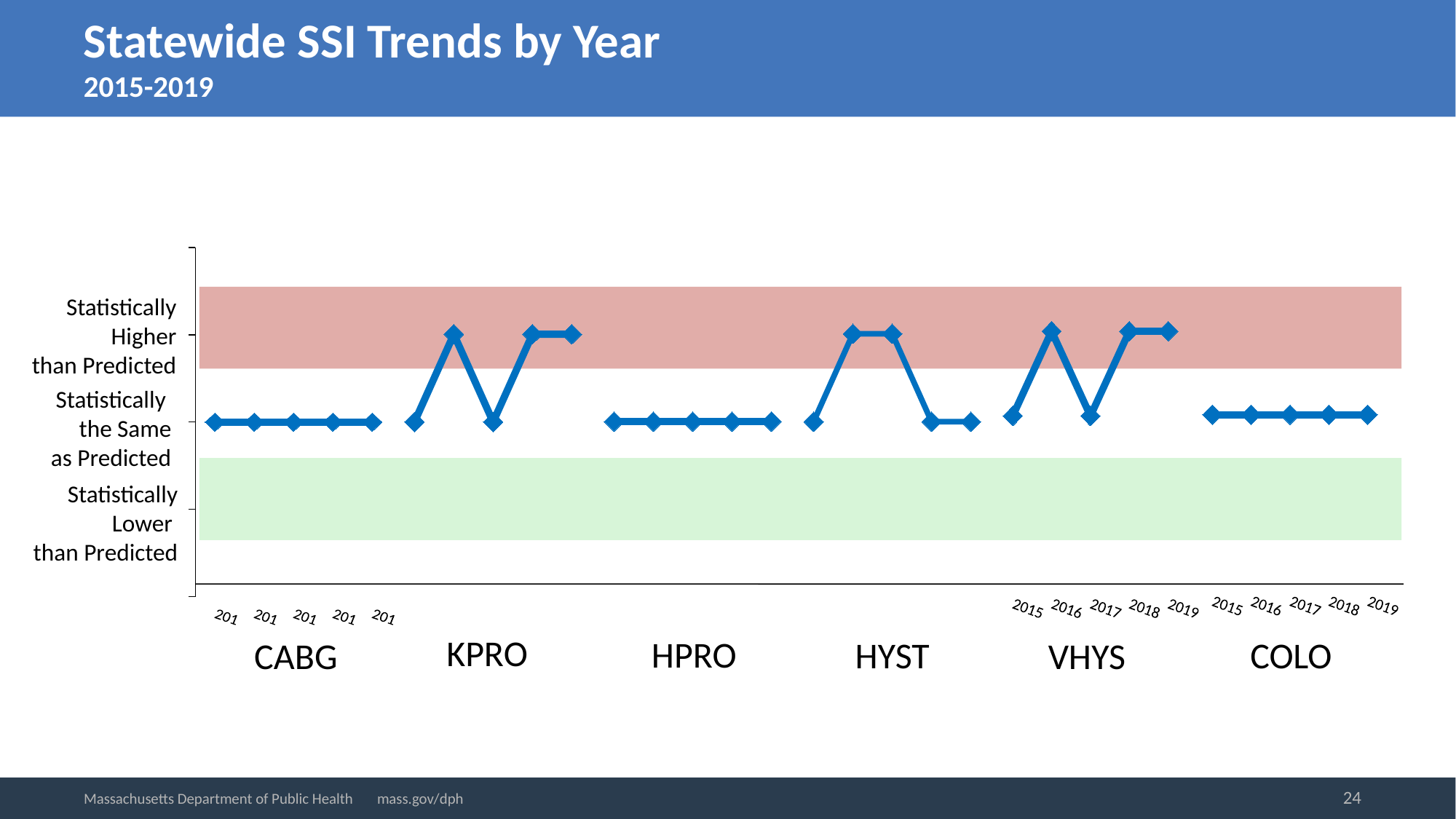
How many of the five VHYS points fall in the Statistically Higher than Predicted band? 3 In which band does the VHYS value for 2019 fall? Statistically Higher than Predicted How many data points are plotted for the VHYS group? 5 Do any points on the chart fall in the Statistically Lower than Predicted band? No In which band does the COLO value for 2017 fall? Statistically the Same as Predicted Is the VHYS value for 2018 higher or lower than the VHYS value for 2017? Higher How many procedure groups are plotted along the x axis of the chart? 6 Do the COLO values rise, fall, or stay flat from 2015 to 2019? Stay flat Which procedure groups stay in the Statistically the Same as Predicted band for all five years? CABG, HPRO, COLO In which band does the VHYS value for 2015 fall? Statistically the Same as Predicted What kind of chart is shown on the slide? Line chart